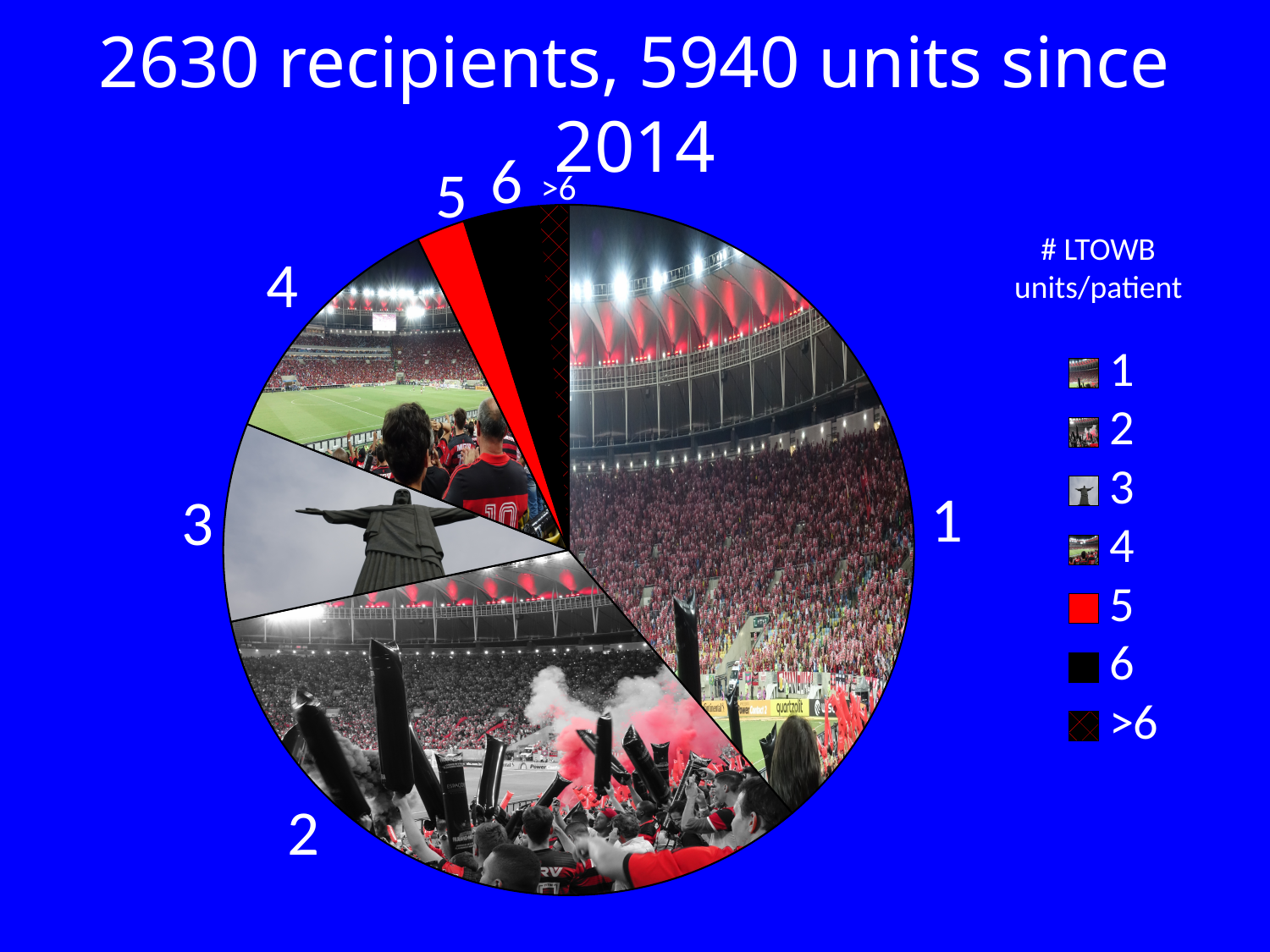
What colour is the slice for 5 units per patient? red What is the title of the legend on the pie chart? # LTOWB units/patient How many entries does the legend list? 7 Which slice is larger, the one for 3 units or the one for 4 units? 4 Which slice is larger, the one for 2 units or the one for 3 units? 2 Which slice is larger, the one for 1 unit or the one for 2 units? 1 Which category has the largest slice of the pie? 1 Which category has the smallest slice of the pie? >6 What kind of chart is shown on the slide? pie chart How many slices does the pie chart have? 7